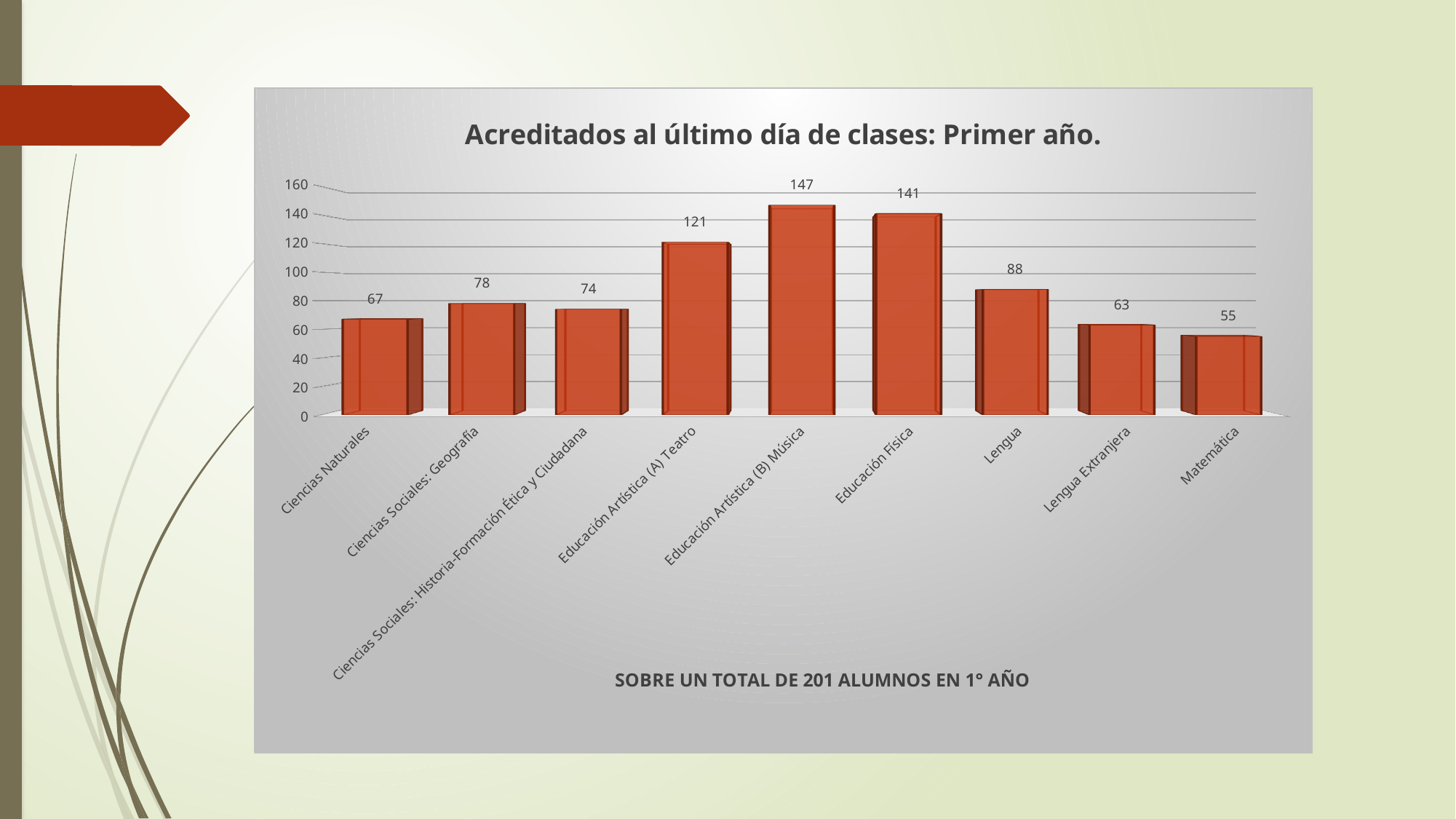
What is the title of the chart? Acreditados al último día de clases: Primer año. What kind of chart is shown on the slide? bar chart Which is larger, the value for Lengua or the value for Ciencias Naturales? Lengua Is the value for Educación Artística (A) Teatro greater or less than 100? greater What is the value for Ciencias Sociales: Geografía? 78 What is the difference between the values for Educación Artística (B) Música and Matemática? 92 What is the difference between the values for Ciencias Sociales: Geografía and Ciencias Sociales: Historia-Formación Ética y Ciudadana? 4 Which category has the highest value? Educación Artística (B) Música How many categories are shown on the x axis? 9 Which category has the lowest value? Matemática What is the value for Lengua Extranjera? 63 What is the value for Educación Física? 141